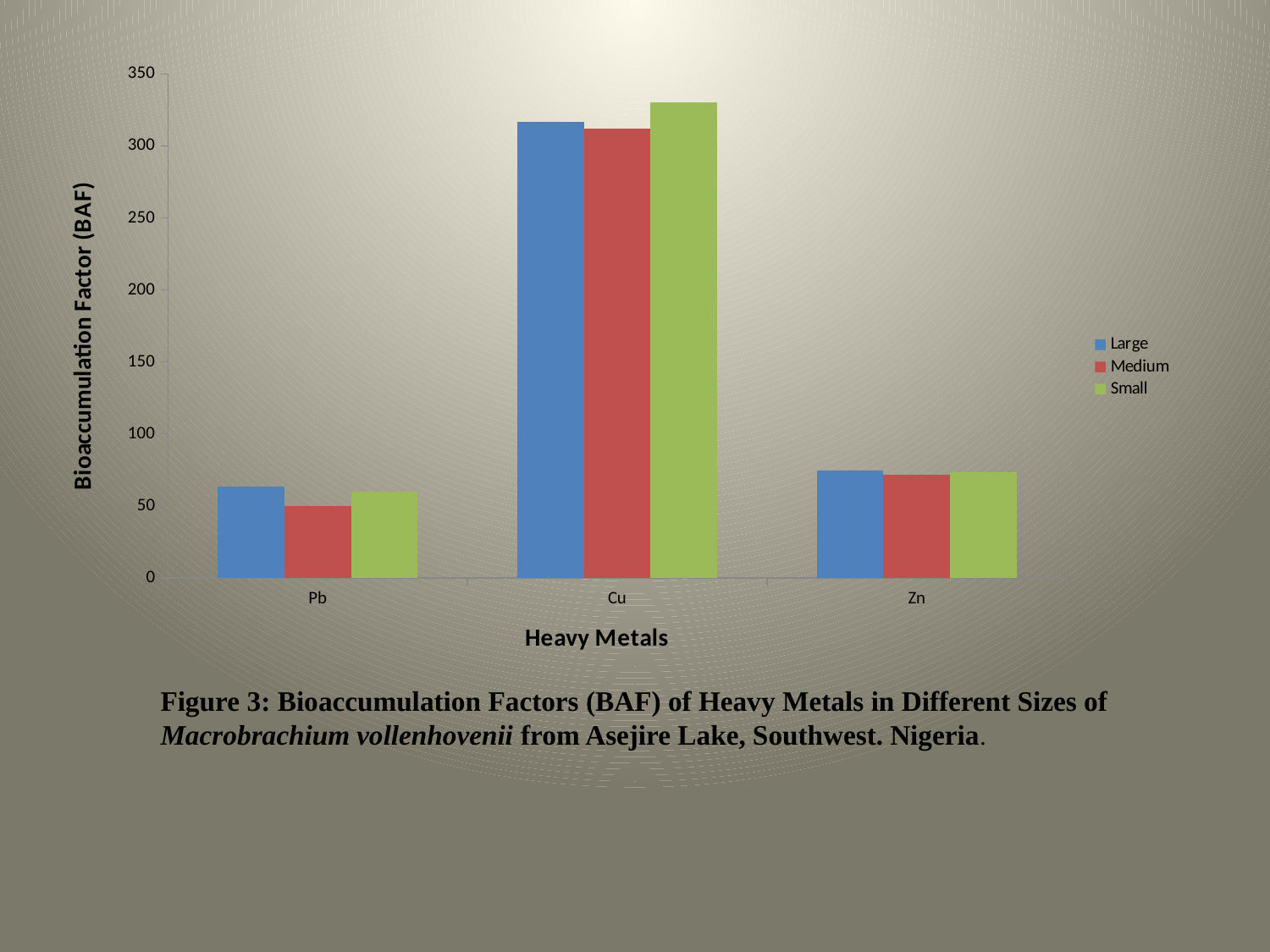
Which heavy metal has the lowest bioaccumulation factor for the Medium size? Pb Is the value for Cu in the Small size greater or less than 300? greater Is the value for Cu in the Medium size greater or less than 350? less What is the title of the x axis? Heavy Metals What kind of chart is shown on the slide? bar chart How many heavy metal categories are shown on the x axis? 3 Is the value for Zn in the Large size greater or less than 50? greater What is the title of the y axis? Bioaccumulation Factor (BAF) For Pb, which is larger: the Large bar or the Medium bar? Large Which heavy metal has the highest bioaccumulation factor for the Large size? Cu How many series does the legend list? 3